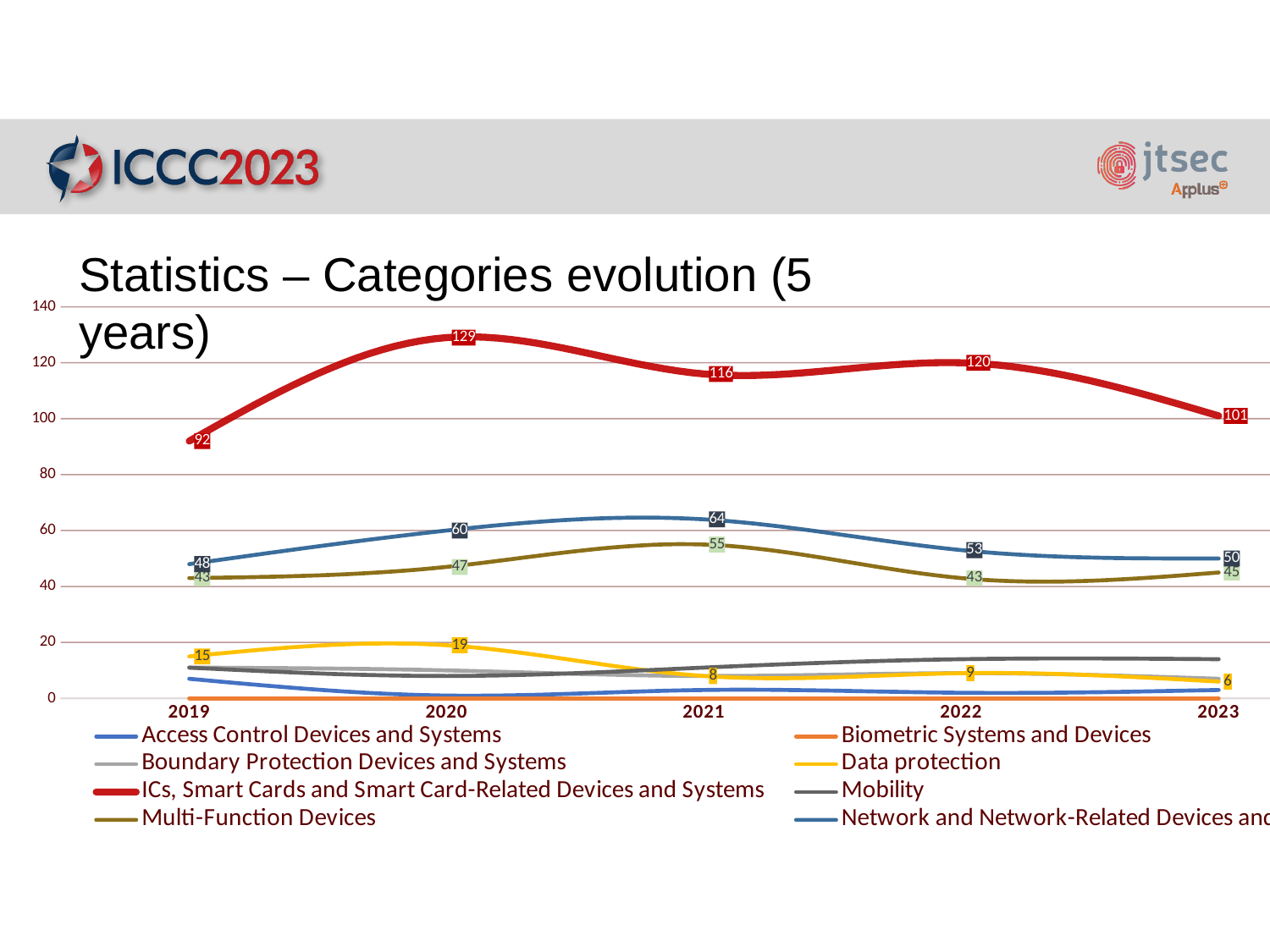
Is the value for ICs, Smart Cards and Smart Card-Related Devices and Systems in 2019 greater or less than 100? less Which is larger in 2022: the Multi-Function Devices value or the Data protection value? Multi-Function Devices What kind of chart is shown on the slide? line chart How many series does the legend list? 8 What is the difference between the ICs, Smart Cards and Smart Card-Related Devices and Systems values in 2020 and 2023? 28 What is the value for Data protection in 2023? 6 In which year is the Data protection series at its lowest value? 2023 In which year does the ICs, Smart Cards and Smart Card-Related Devices and Systems series reach its highest value? 2020 Does the ICs, Smart Cards and Smart Card-Related Devices and Systems series rise or fall from 2022 to 2023? fall What is the value for Multi-Function Devices in 2021? 55 What is the value for ICs, Smart Cards and Smart Card-Related Devices and Systems in 2020? 129 How many years are shown on the x axis? 5